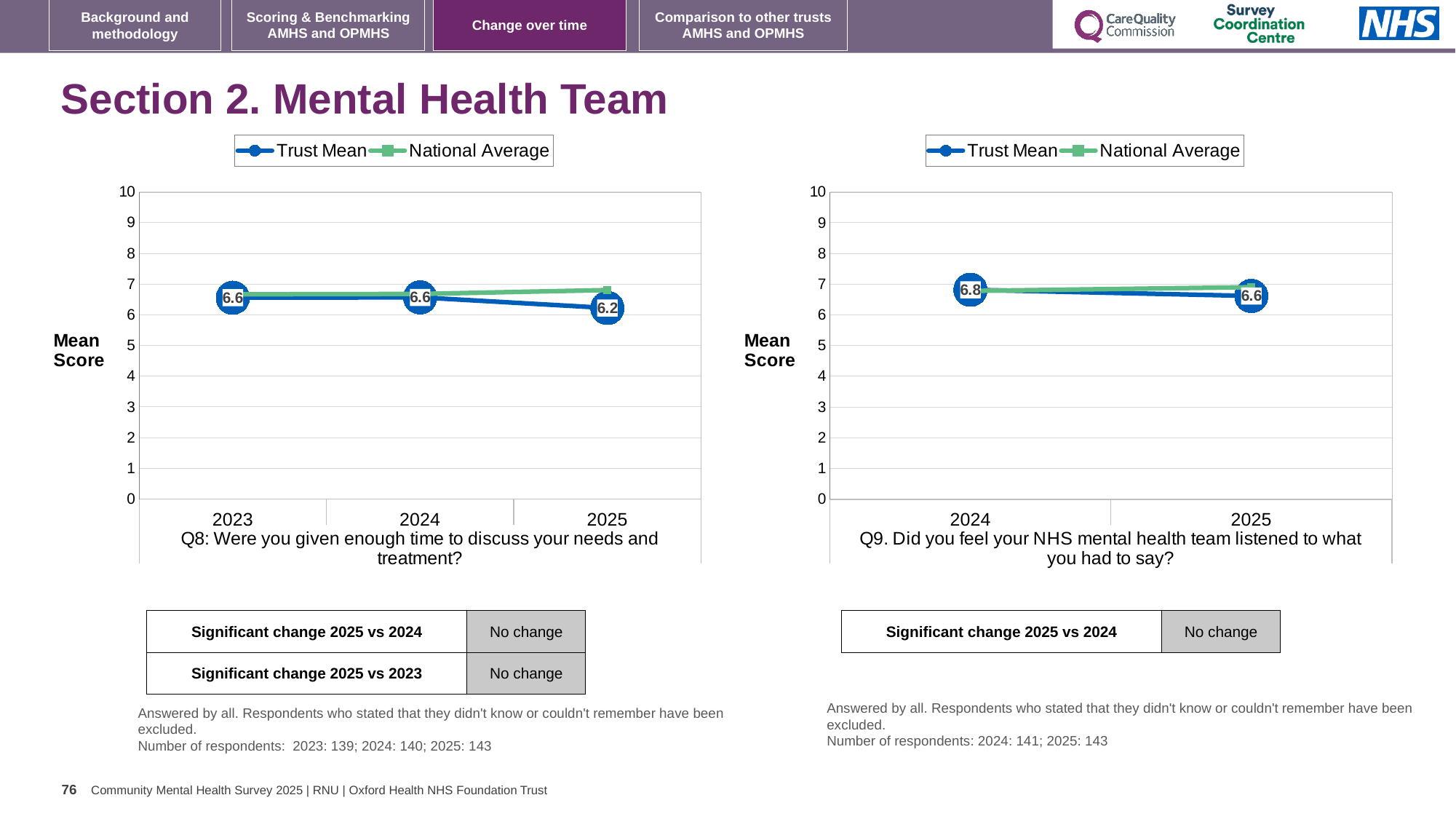
On the Q9 chart (right), what is the difference between the Trust Mean for 2024 and 2025? 0.2 On the Q8 chart (left), what is the Trust Mean for 2023? 6.6 On the Q8 chart (left), which year has the lowest Trust Mean? 2025 On the Q9 chart (right), what is the Trust Mean for 2025? 6.6 On the Q8 chart (left), what is the difference between the Trust Mean for 2024 and the Trust Mean for 2025? 0.4 On the Q9 chart (right), what is the Trust Mean for 2024? 6.8 How many series does the legend of the Q9 chart (right) list? 2 How many years are plotted on the Q8 chart (left)? 3 On the Q8 chart (left), is the National Average for 2025 greater or less than 6? greater What kind of chart is the Q9 chart (right)? Line chart On the Q8 chart (left), what is the Trust Mean for 2025? 6.2 On the Q8 chart (left), is the Trust Mean larger in 2023 or in 2025? 2023